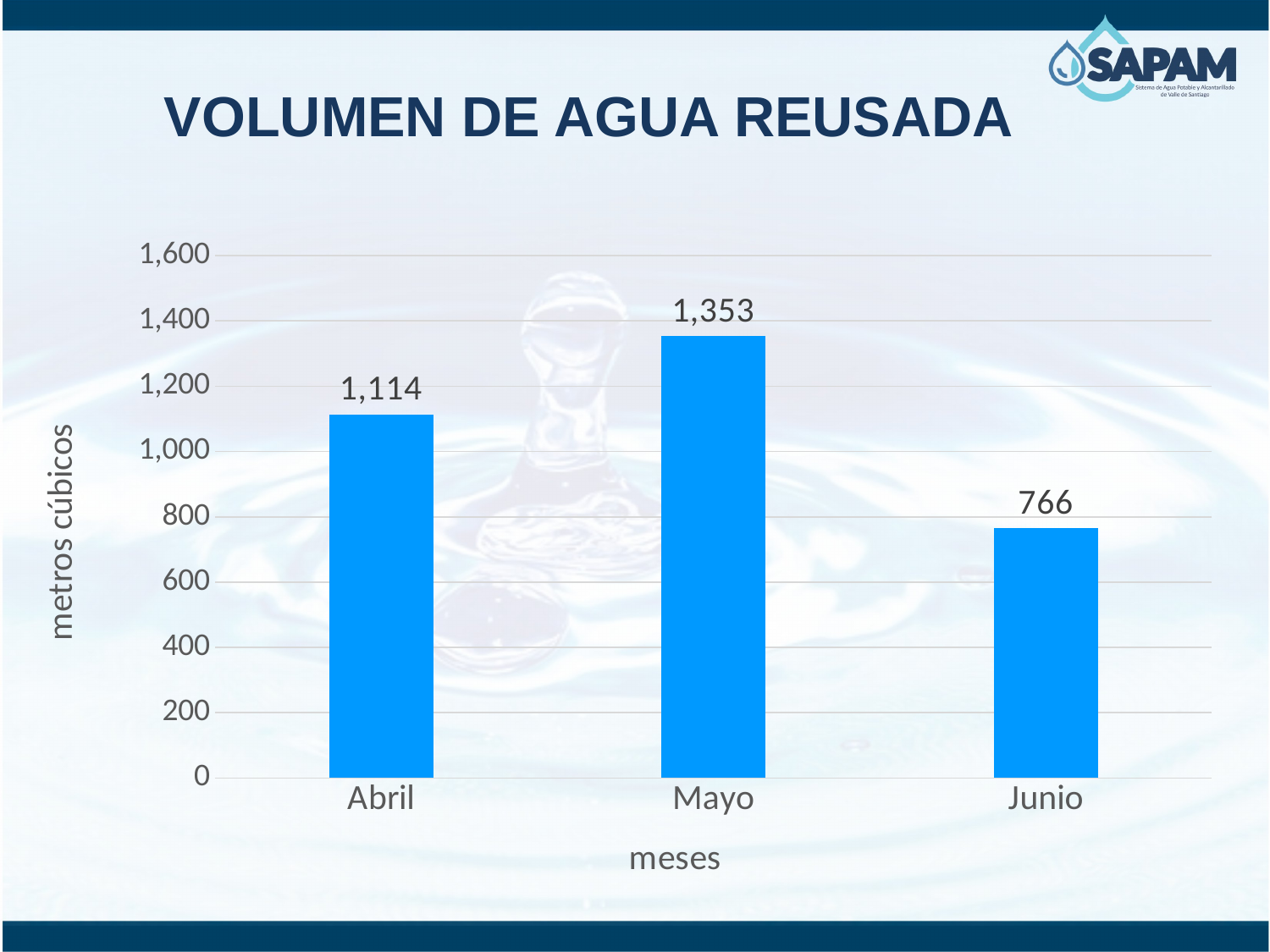
What is the value for Abril? 1,114 How many months are shown on the chart? 3 What is the difference between the values for Mayo and Abril? 239 What is the title of the chart? VOLUMEN DE AGUA REUSADA What kind of chart is shown on the slide? bar chart Which month has the lowest volume of reused water? Junio What is the value for Junio? 766 Which is larger, the value for Abril or the value for Junio? Abril Which month has the highest volume of reused water? Mayo What is the value for Mayo? 1,353 What is the difference between the values for Abril and Junio? 348 Is the value for Junio greater or less than 800? less